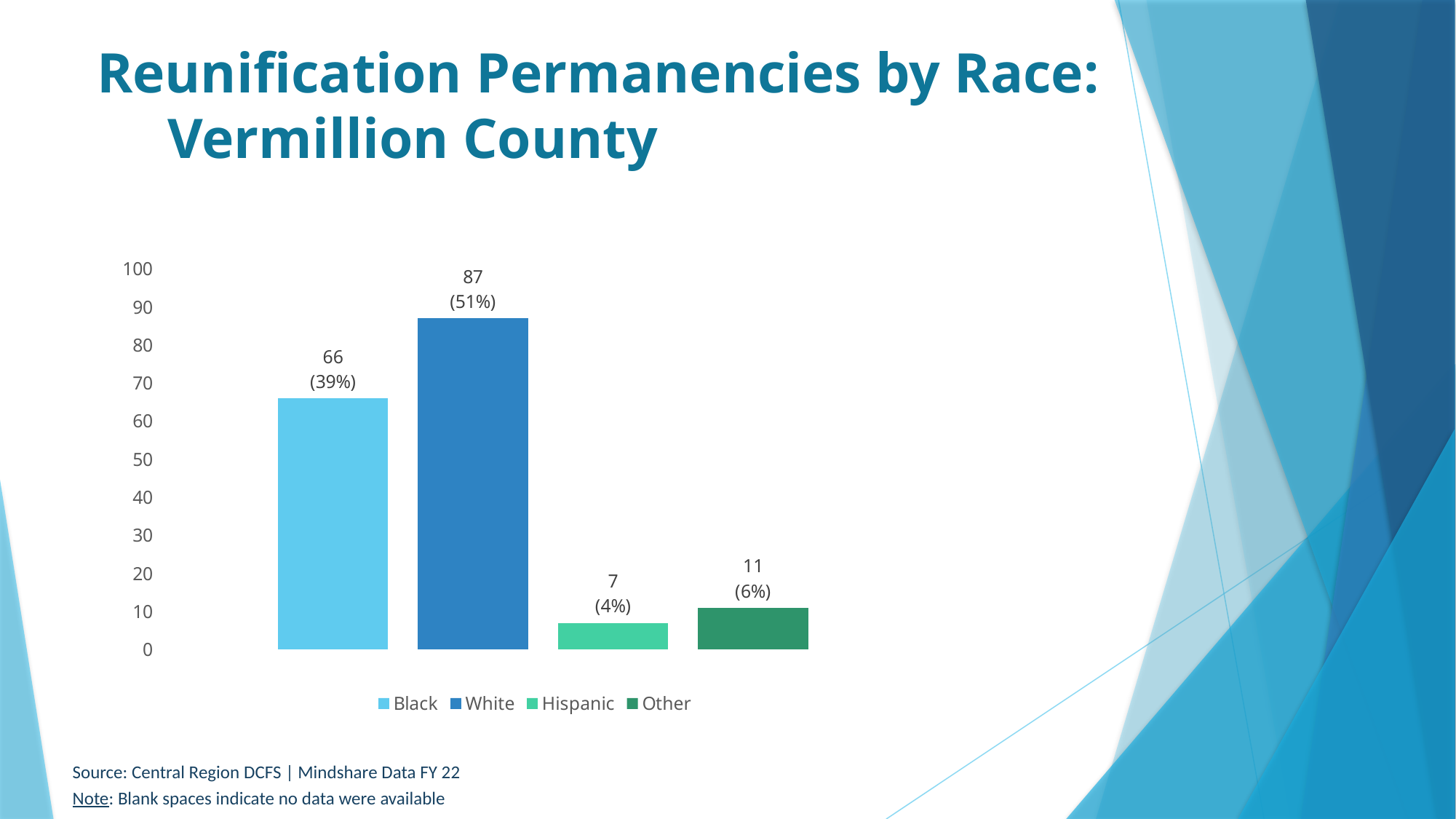
What is the number of reunification permanencies for Black? 66 What is the title of the slide? Reunification Permanencies by Race: Vermillion County Which race has the highest number of reunification permanencies? White What is the value for Other? 11 What kind of chart is shown on the slide? Bar chart Which is larger, the value for Other or the value for Hispanic? Other What is the difference between the White and Black values? 21 Which race has the lowest number of reunification permanencies? Hispanic What is the number of reunification permanencies for White? 87 Is the value for Black greater or less than 60? greater What percentage is shown for Hispanic? 4% How many series does the legend list? 4